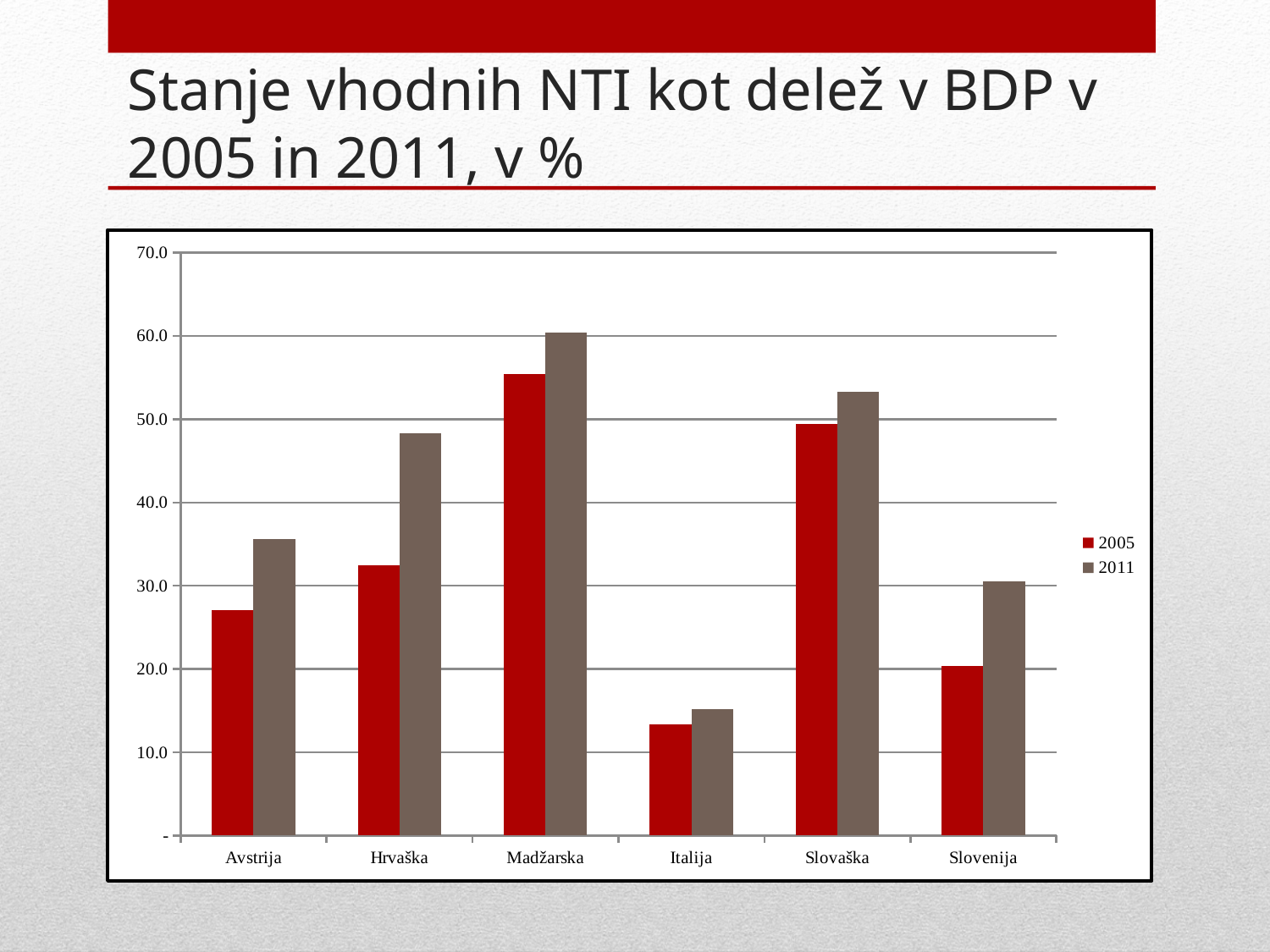
How many series does the legend list? 2 Which country has the lowest value for 2005? Italija Is the 2011 value for Hrvaška greater or less than 40.0? greater What kind of chart is shown on the slide? bar chart Which is larger: the 2011 value for Hrvaška or the 2011 value for Slovaška? Slovaška Which series is shown in red in the chart? 2005 How many countries are shown on the x axis of the chart? 6 Which country has the highest value for 2011? Madžarska Is the 2011 value for Slovaška greater or less than 50.0? greater Is the 2005 value for Avstrija greater or less than 30.0? less For each country, is the 2011 value higher or lower than the 2005 value? higher Which country has the lowest value for 2011? Italija